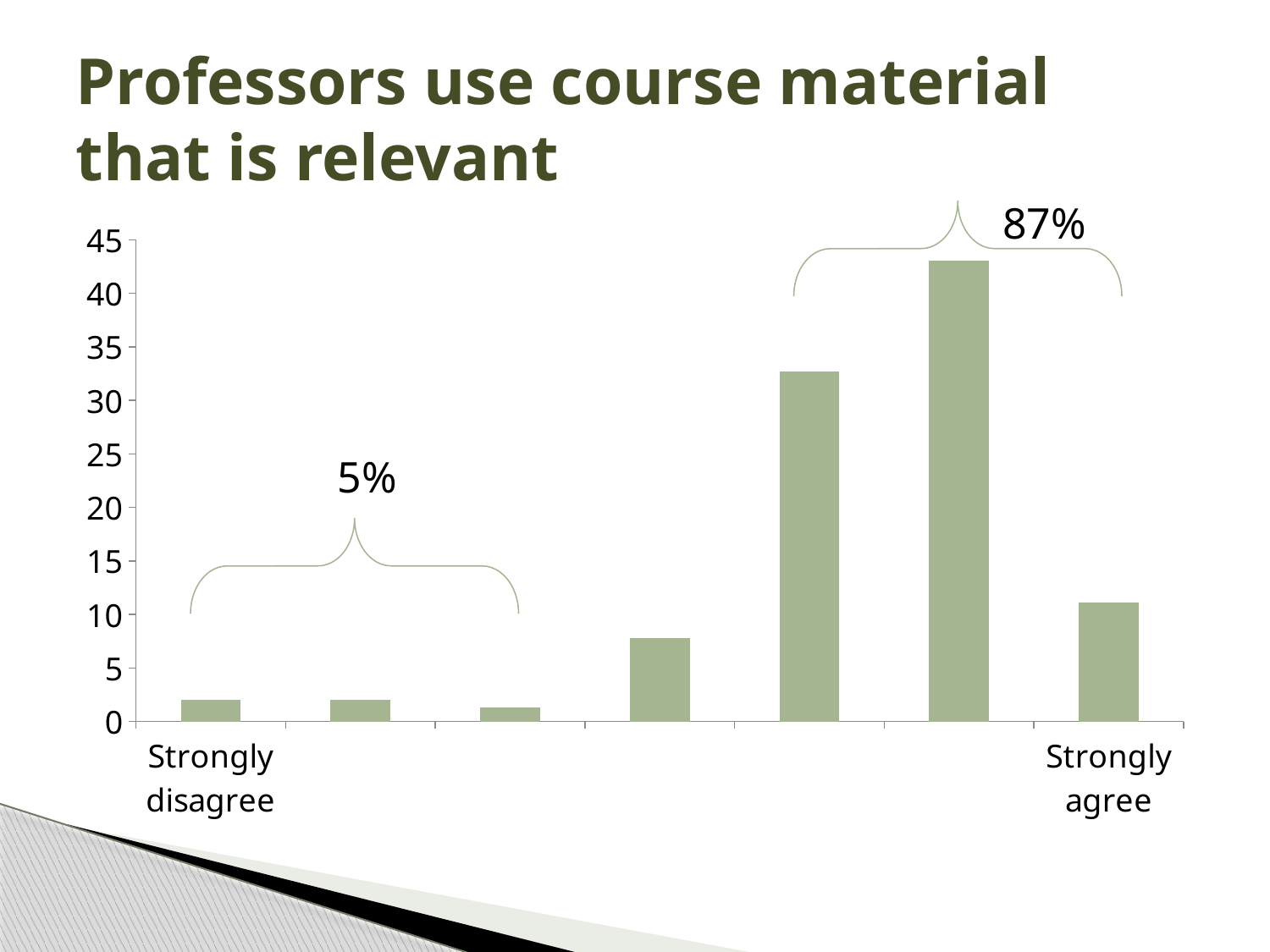
How many bars are plotted in the chart? 7 What percentage is shown above the bracket covering the three rightmost bars? 87% Is the value of the fifth bar from the left greater or less than 30? greater Is the value for Strongly disagree greater or less than 5? less Which bar is the tallest in the chart? the second bar from the right (sixth from the left) Which is larger, the value for Strongly agree or the value for Strongly disagree? Strongly agree What is the label of the leftmost category on the x axis? Strongly disagree Is the value for Strongly agree greater or less than 15? less What kind of chart is shown on the slide? bar chart What is the label of the rightmost category on the x axis? Strongly agree